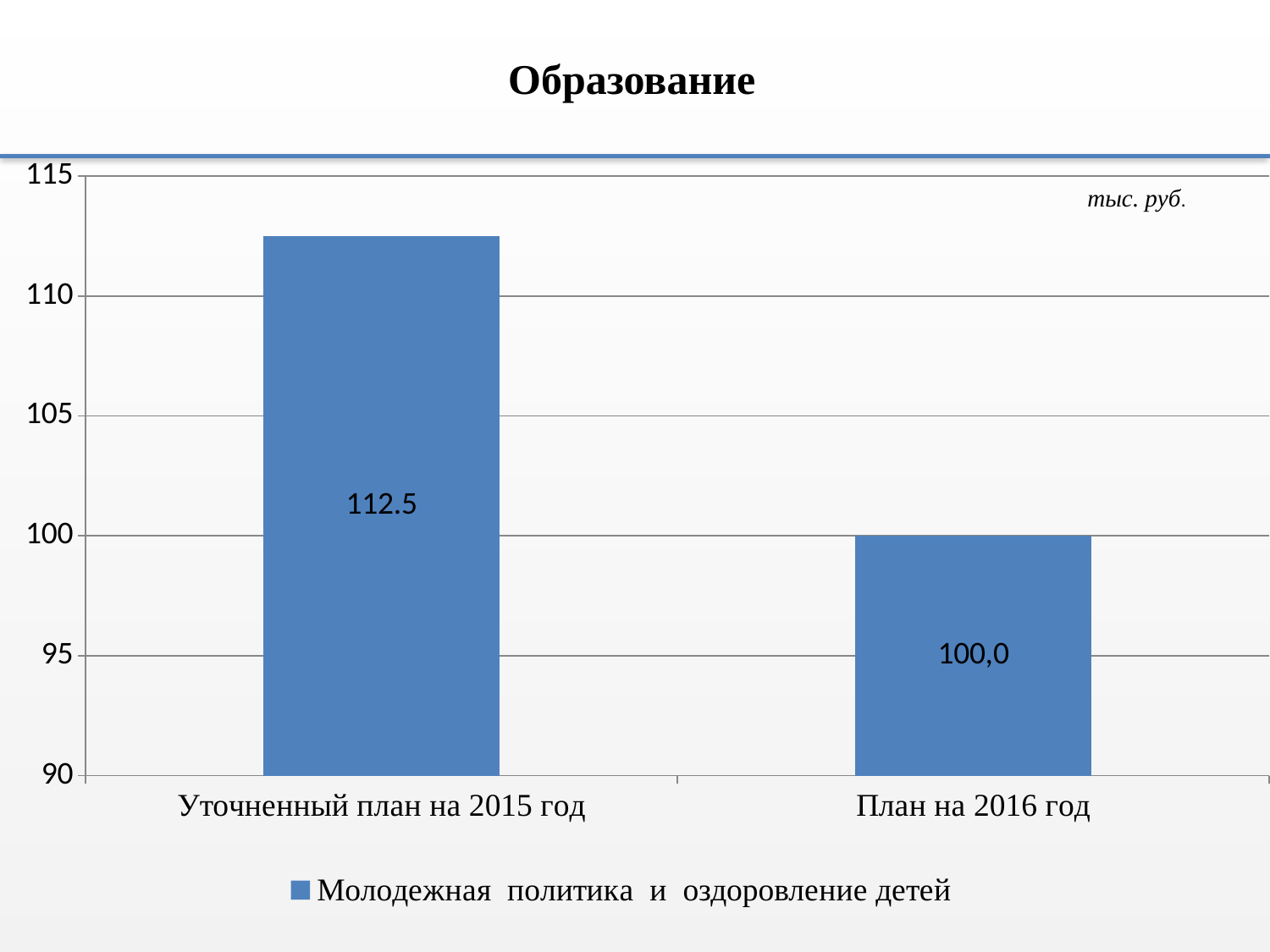
What series name is listed in the legend? Молодежная политика и оздоровление детей Do the values rise or fall from Уточненный план на 2015 год to План на 2016 год? fall Which category has the highest value? Уточненный план на 2015 год Which is larger: the value for Уточненный план на 2015 год or the value for План на 2016 год? Уточненный план на 2015 год Is the value for Уточненный план на 2015 год greater or less than 110? greater Which category has the lowest value? План на 2016 год How many categories are shown on the x axis? 2 What kind of chart is shown on the slide? bar chart What is the value for Уточненный план на 2015 год? 112.5 What is the difference between the value for Уточненный план на 2015 год and the value for План на 2016 год? 12.5 How many series does the legend list? 1 What is the value for План на 2016 год? 100,0